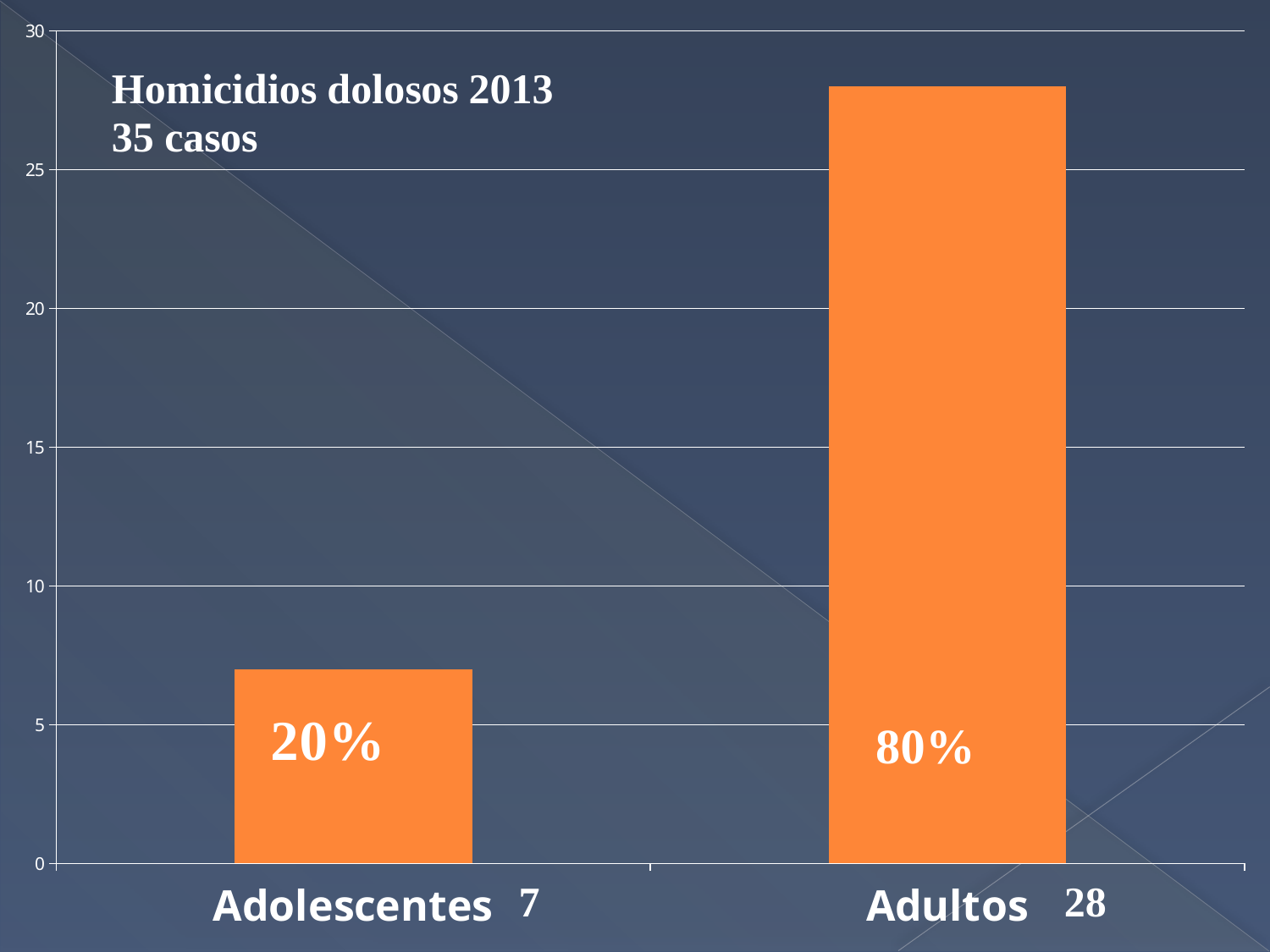
Which is larger, the value for Adolescentes or the value for Adultos? Adultos What is the title of the chart? Homicidios dolosos 2013 35 casos What is the value for Adolescentes? 7 Which category has the lowest value? Adolescentes What percentage is shown inside the Adultos bar? 80% What is the difference between the values for Adultos and Adolescentes? 21 What percentage is shown inside the Adolescentes bar? 20% Which category has the highest value? Adultos Is the value for Adultos greater or less than 25? greater How many categories are shown on the chart? 2 What is the value for Adultos? 28 What kind of chart is shown on the slide? bar chart